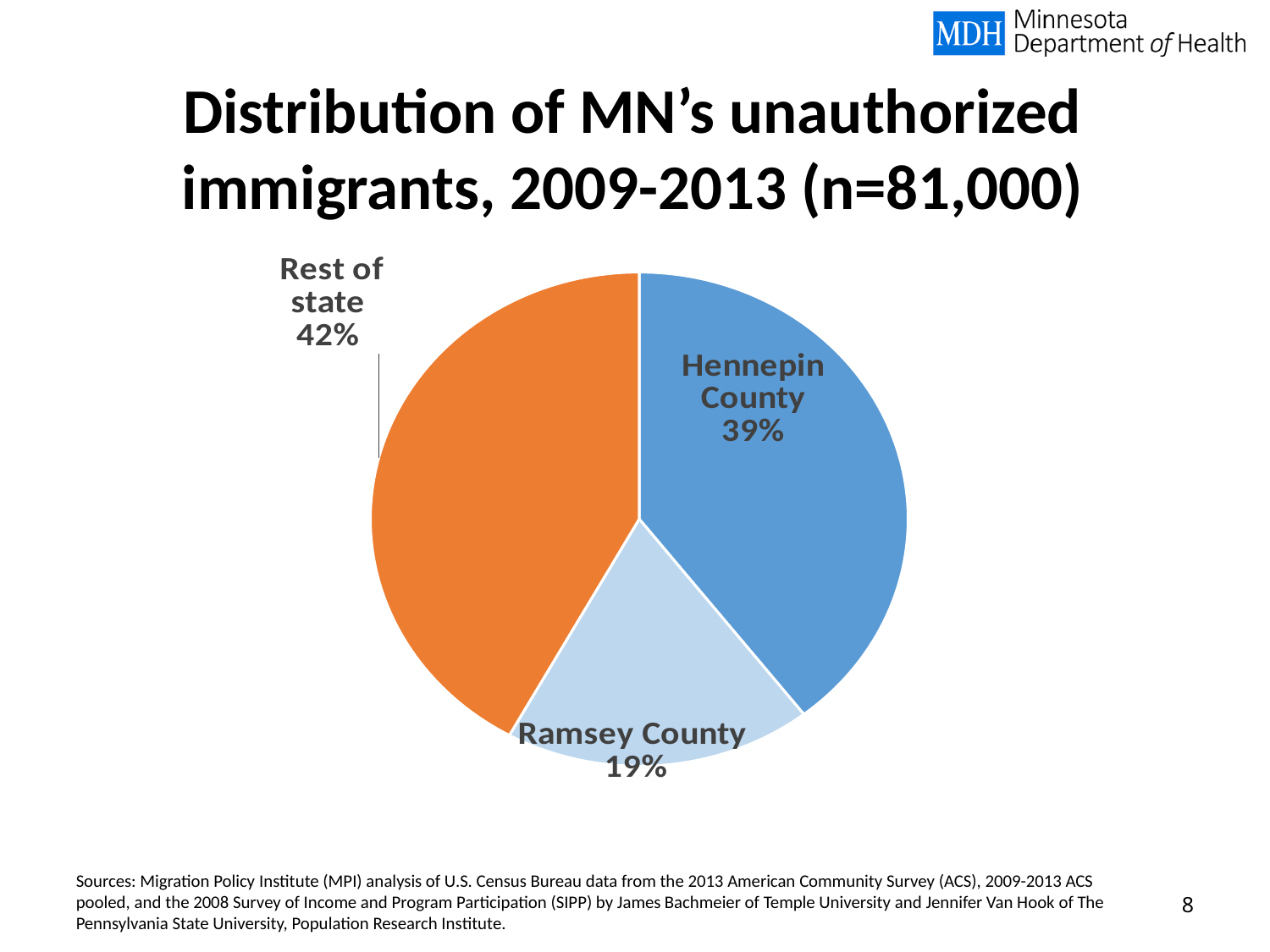
What is the difference in percentage points between Rest of state and Hennepin County? 3 What kind of chart is shown on the slide? Pie chart Which slice of the pie is the largest? Rest of state How many slices does the pie chart have? 3 What share of MN's unauthorized immigrants is in Ramsey County? 19% What share of MN's unauthorized immigrants is in the rest of the state? 42% Which slice of the pie is the smallest? Ramsey County Which is larger, the share for Hennepin County or the share for Ramsey County? Hennepin County What is the difference in percentage points between Hennepin County and Ramsey County? 20 What is the total number of unauthorized immigrants (n) given in the chart title? 81,000 What share of MN's unauthorized immigrants is in Hennepin County? 39% What is the combined share of Hennepin County and Ramsey County? 58%